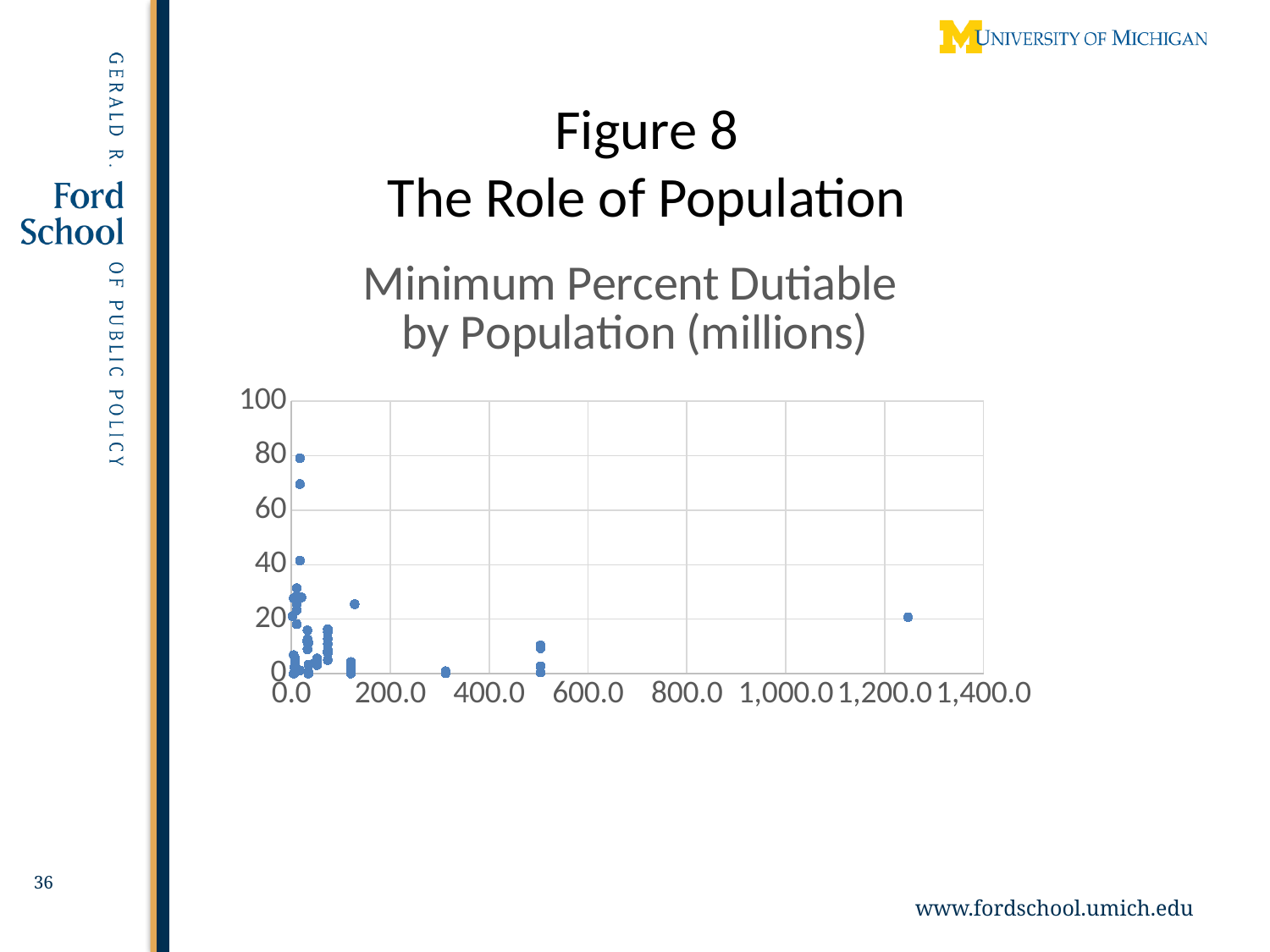
What is the title of the chart? Minimum Percent Dutiable by Population (millions) Is the highest point on the chart greater or less than 60 on the vertical axis? greater What kind of chart is shown on the slide? scatter plot Is the point plotted near a population of 300 million greater or less than 20 on the vertical axis? less Which is larger: the vertical-axis value of the highest point near a population of 0, or the value of the point near a population of 1,250 million? the point near a population of 0 What is the highest value shown on the vertical axis of the chart? 100 What is the largest tick label shown on the horizontal axis of the chart? 1,400.0 Is the point plotted near a population of 130 million greater or less than 40 on the vertical axis? less Are most of the points on the chart located at populations below or above 200 million? below